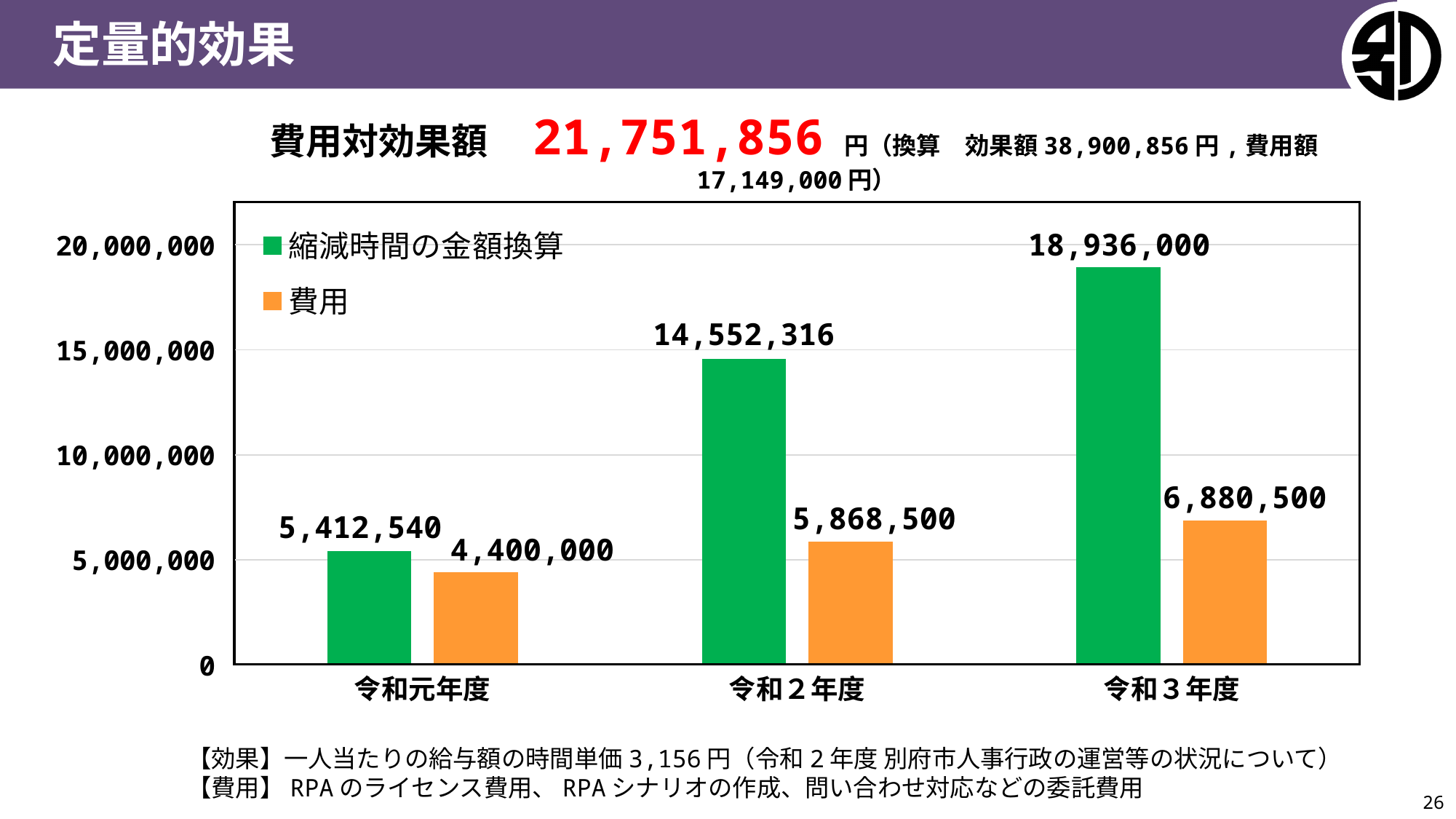
Is the value of 縮減時間の金額換算 for 令和２年度 greater or less than 10,000,000? greater Which year has the highest value for 縮減時間の金額換算? 令和３年度 Which is larger for 令和２年度: 縮減時間の金額換算 or 費用? 縮減時間の金額換算 How many series does the legend list? 2 What is the value of 費用 for 令和３年度? 6,880,500 What is the value of 費用 for 令和元年度? 4,400,000 What is the difference between 縮減時間の金額換算 and 費用 for 令和３年度? 12,055,500 Which year has the lowest value for 費用? 令和元年度 What is the value of 縮減時間の金額換算 for 令和２年度? 14,552,316 Does the value of 費用 rise or fall from 令和元年度 to 令和３年度? rise What is the difference between 縮減時間の金額換算 and 費用 for 令和元年度? 1,012,540 How many years are shown on the x axis? 3